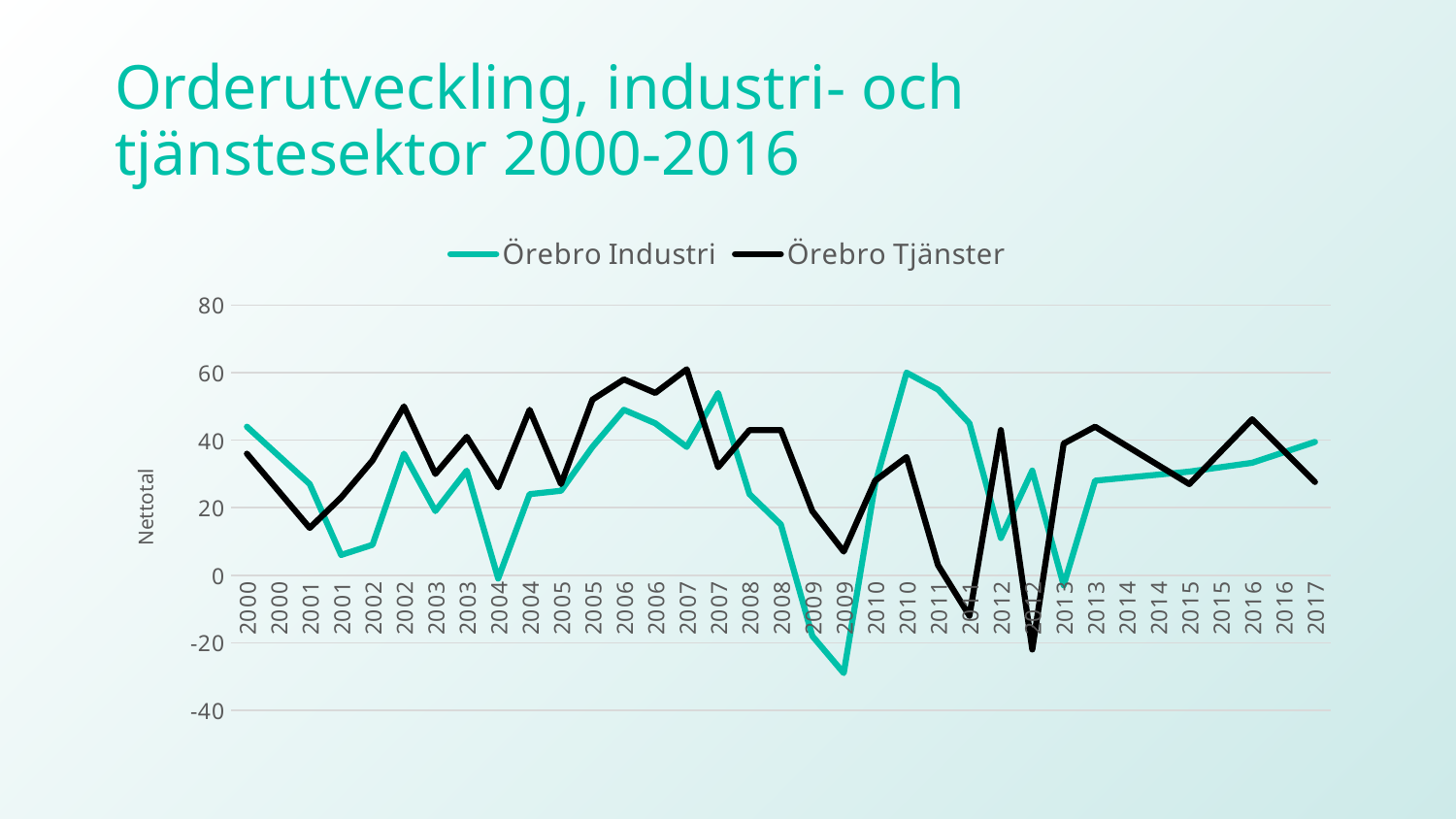
What kind of chart is shown on the slide? line chart In which year does the Örebro Industri series reach its lowest value? 2009 What are the two series named in the legend? Örebro Industri and Örebro Tjänster At the first 2004 point, which series has the higher value, Örebro Industri or Örebro Tjänster? Örebro Tjänster Is the lowest value of Örebro Tjänster (in 2012) greater or less than 0? less What is the label on the vertical axis? Nettotal Is the lowest value of Örebro Industri (in 2009) greater or less than -20? less In which year does the Örebro Tjänster series reach its lowest value? 2012 Is the value for Örebro Industri at the last point (2017) greater or less than 20? greater At the last point (2017), which series has the higher value, Örebro Industri or Örebro Tjänster? Örebro Industri In which year does the Örebro Industri series reach its highest value? 2010 How many series does the legend list? 2